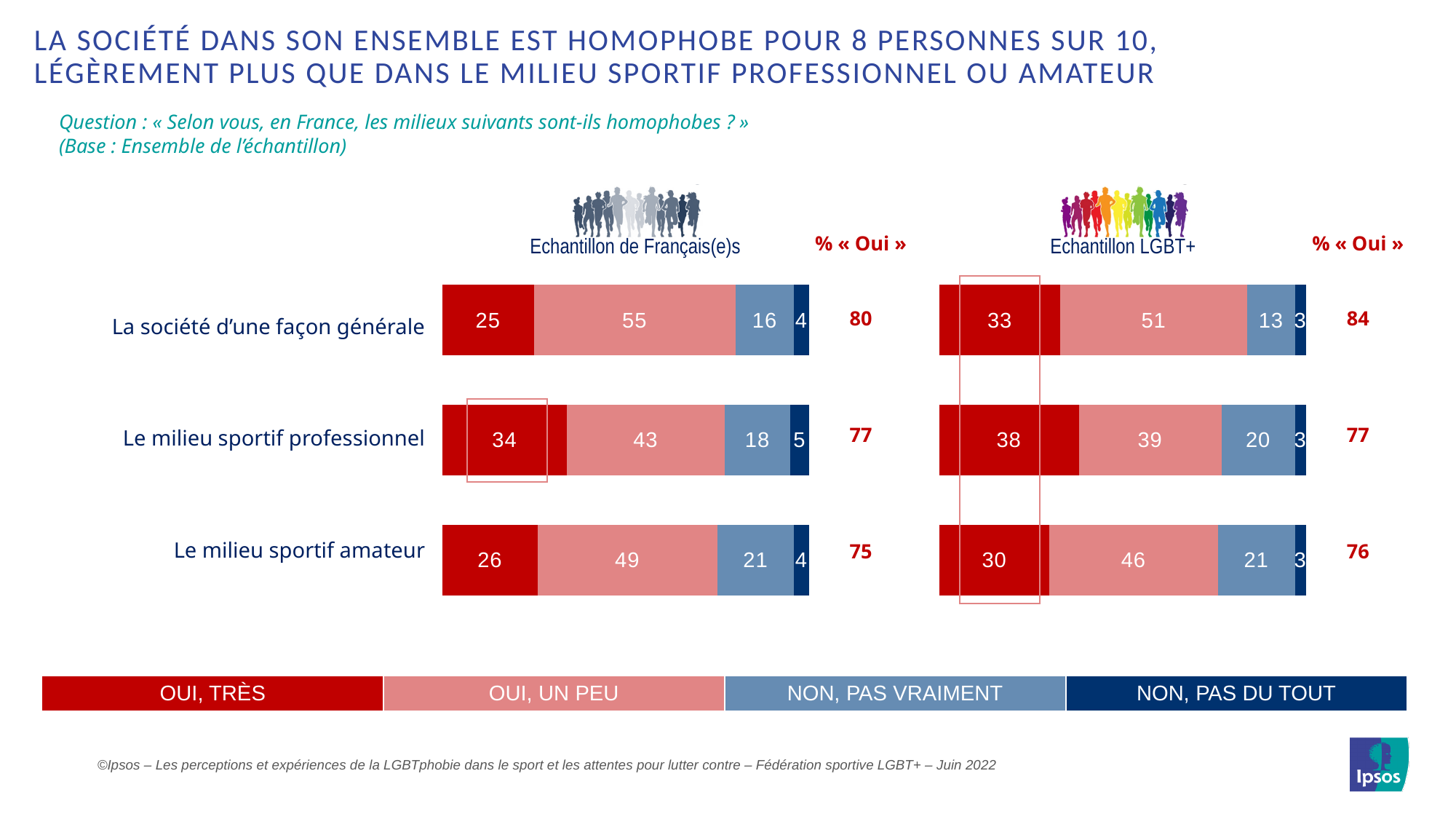
In the Echantillon LGBT+ chart, which category has the lowest "Oui, très" value? Le milieu sportif amateur In the Echantillon LGBT+ chart, what is the "% « Oui »" for "La société d'une façon générale"? 84 In the Echantillon de Français(e)s chart, what is the difference between the "Oui, un peu" values for "La société d'une façon générale" and "Le milieu sportif professionnel"? 12 What kind of chart is used for the Echantillon LGBT+ data? Stacked bar chart In the Echantillon LGBT+ chart, which is larger: "Non, pas vraiment" for "Le milieu sportif professionnel" or for "La société d'une façon générale"? Le milieu sportif professionnel Which colour represents "Non, pas du tout" in the legend? Dark blue In the Echantillon de Français(e)s chart, what is the total of "Oui, très" and "Oui, un peu" for "Le milieu sportif amateur"? 75 How many series does the legend list? 4 In the Echantillon LGBT+ chart, what is the value of "Oui, un peu" for "La société d'une façon générale"? 51 In the Echantillon de Français(e)s chart, which category has the highest "Oui, très" value? Le milieu sportif professionnel In the Echantillon de Français(e)s chart, what is the value of "Oui, très" for "Le milieu sportif professionnel"? 34 How many categories are shown in the Echantillon de Français(e)s chart? 3